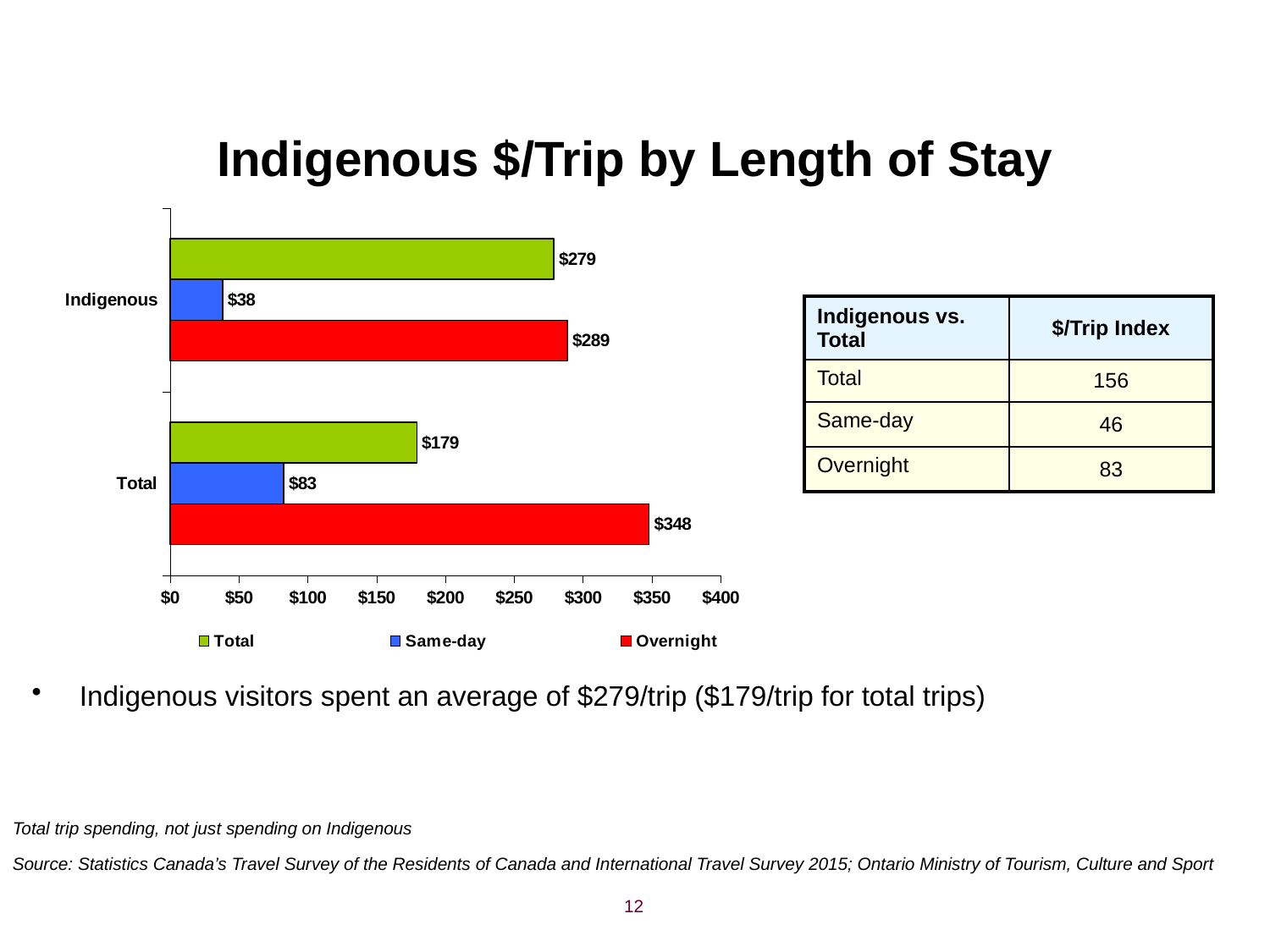
How many series does the legend list? 3 What is the Overnight $/trip value for Indigenous? $289 Which series has the lowest value in the Indigenous category? Same-day What kind of chart is shown on the slide? bar chart What is the Same-day $/trip value for Total? $83 Which is larger, the Total series value for Indigenous or for Total? Indigenous Which series has the highest value in the Total category? Overnight What is the difference between the Overnight values for Total and Indigenous? $59 What is the difference between the Same-day values for Total and Indigenous? $45 Is the Overnight value for Total greater or less than $300? greater What is the Total series value for the Indigenous category? $279 What colour are the Overnight bars? red